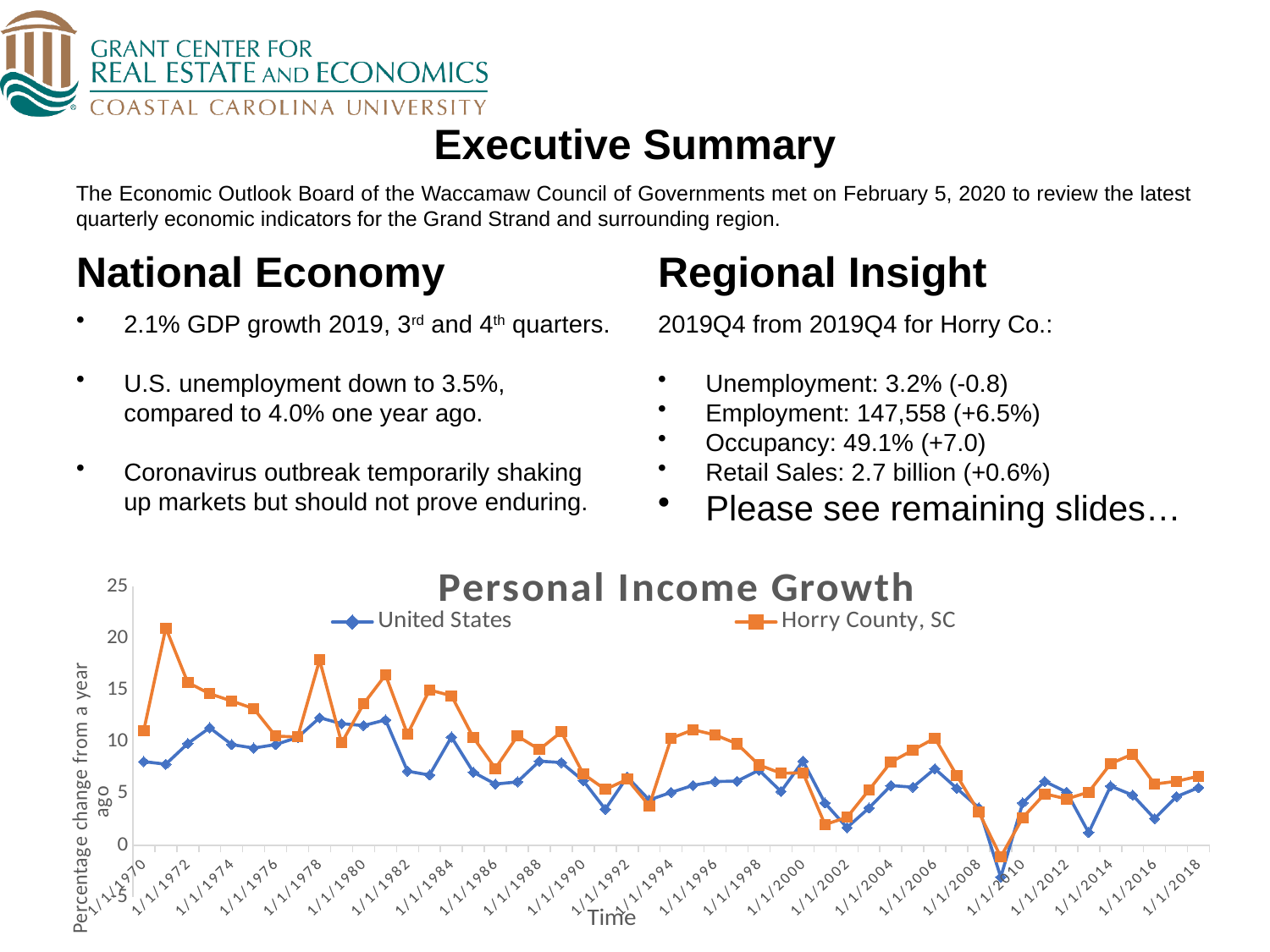
At 1/1/1982, which series has the higher value, United States or Horry County, SC? Horry County, SC What kind of chart is shown on the slide? line chart Overall, do the values on the Personal Income Growth chart rise or fall from 1970 to 2018? fall Is the Horry County, SC value at 1/1/2009 greater or less than 0? less Is the Horry County, SC value at 1/1/2002 greater or less than 5? less Is the Horry County, SC value at 1/1/1978 greater or less than 15? greater What is the title of the chart on the slide? Personal Income Growth What is the y-axis title of the Personal Income Growth chart? Percentage change from a year ago Which series reaches the highest value on the Personal Income Growth chart? Horry County, SC How many series does the legend of the Personal Income Growth chart list? 2